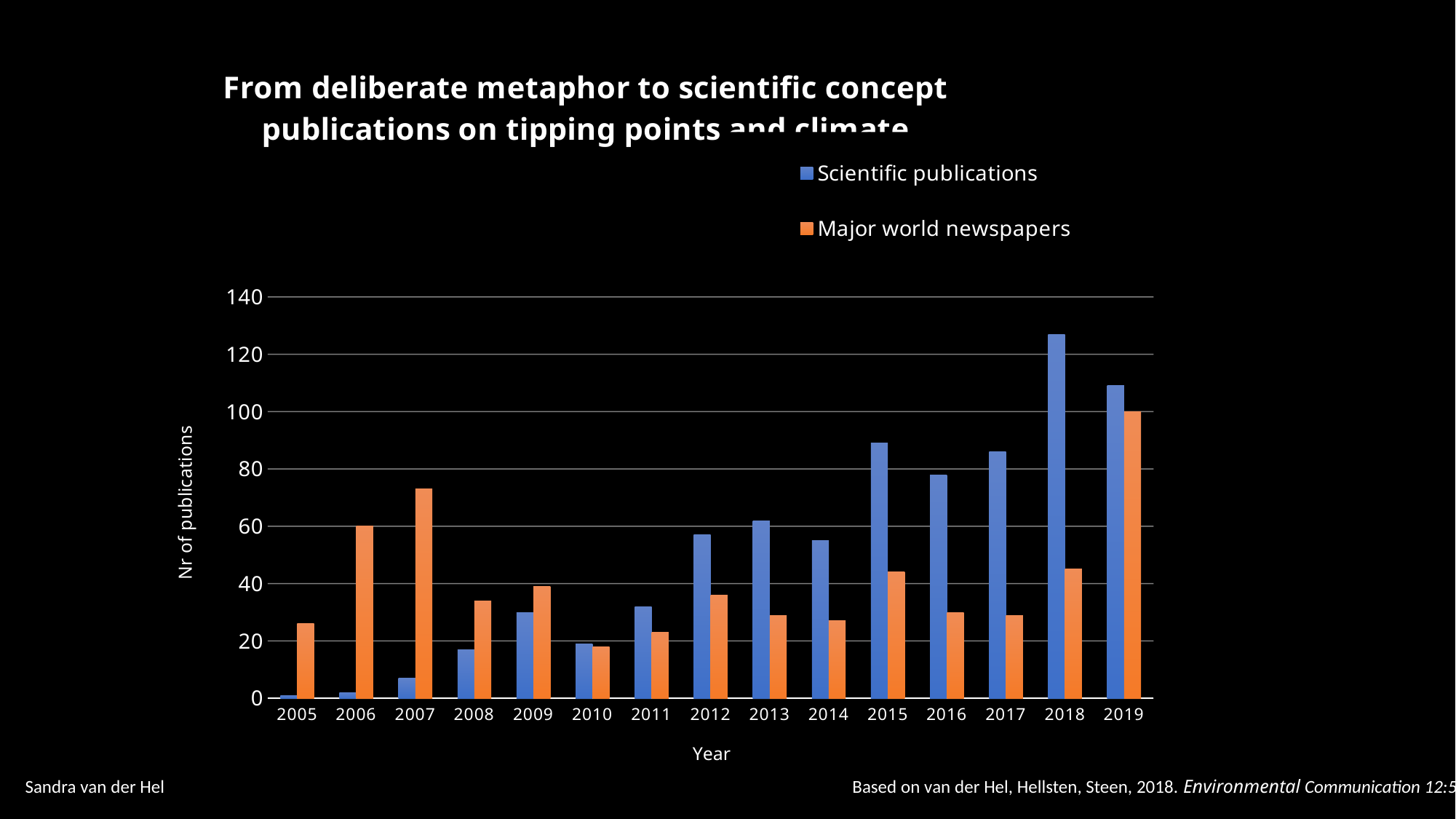
In 2015, which is larger: scientific publications or major world newspapers? Scientific publications In which year is the number of major world newspaper publications highest? 2019 In which year is the number of major world newspaper publications lowest? 2010 Is the value for scientific publications in 2018 greater or less than 120? greater In which year is the number of scientific publications highest? 2018 How many series does the legend list? 2 What kind of chart is shown on the slide? bar chart In 2007, which is larger: scientific publications or major world newspapers? Major world newspapers In which year is the number of scientific publications lowest? 2005 How many years are shown on the x axis? 15 Is the value for major world newspapers in 2007 greater or less than 80? less What is the label on the y axis? Nr of publications